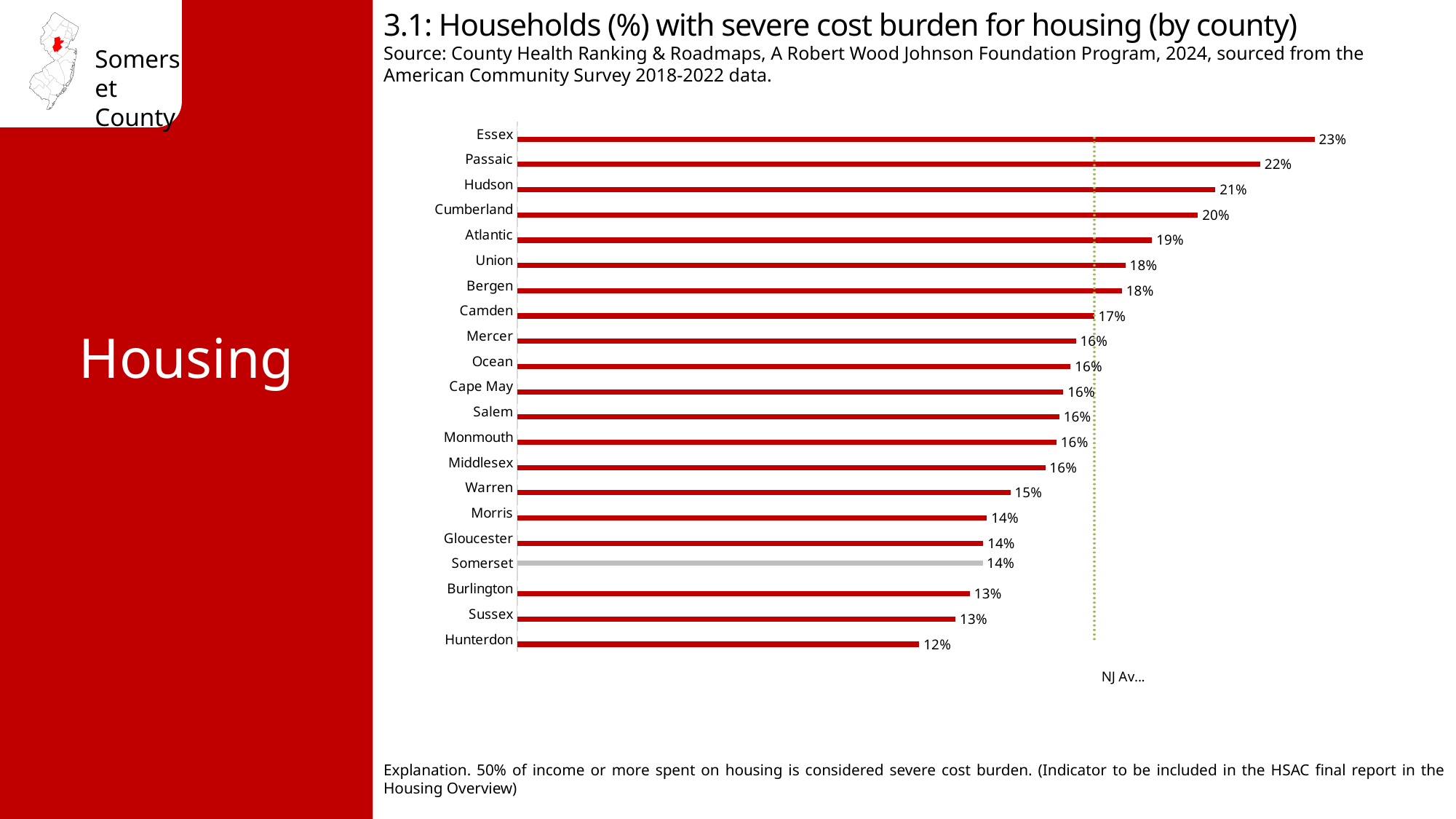
What is the value shown for Hunterdon County? 12% Which has a higher value, Hudson or Atlantic? Hudson Which county has the lowest percentage of households with severe housing cost burden? Hunterdon Do the values rise or fall going from the top bar to the bottom bar? Fall What is the value shown for Cumberland County? 20% Which county's bar is drawn in grey instead of red? Somerset How many counties are shown in the chart? 21 What kind of chart is shown on the slide? Bar chart What is the difference in percentage points between Essex and Somerset? 9 percentage points What is the value shown for Somerset County? 14% Which county has the highest percentage of households with severe housing cost burden? Essex What percentage of households in Essex County have a severe cost burden for housing? 23%